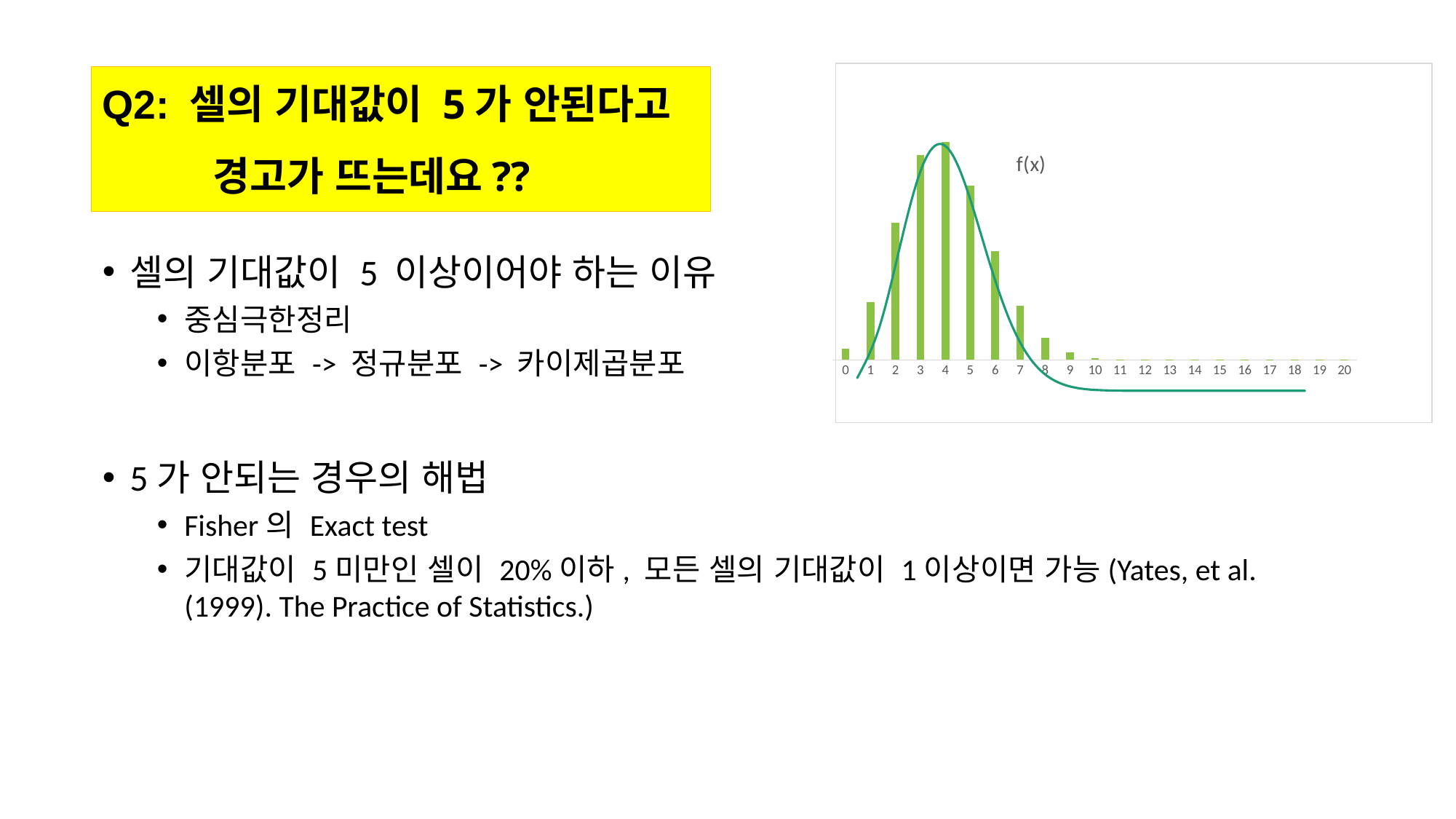
How many categories are labelled along the x axis of the chart? 21 Which category on the x axis has the tallest bar? 4 What is the first category label on the x axis? 0 Which bar is taller, the one at 0 or the one at 2? 2 What text label is printed inside the chart area next to the curve? f(x) What kind of chart is shown on the slide? bar chart Which bar is taller, the one at 8 or the one at 9? 8 Do the bar heights rise or fall from category 0 to category 4? rise Do the bar heights rise or fall from category 4 to category 9? fall Which bar is taller, the one at 2 or the one at 6? 2